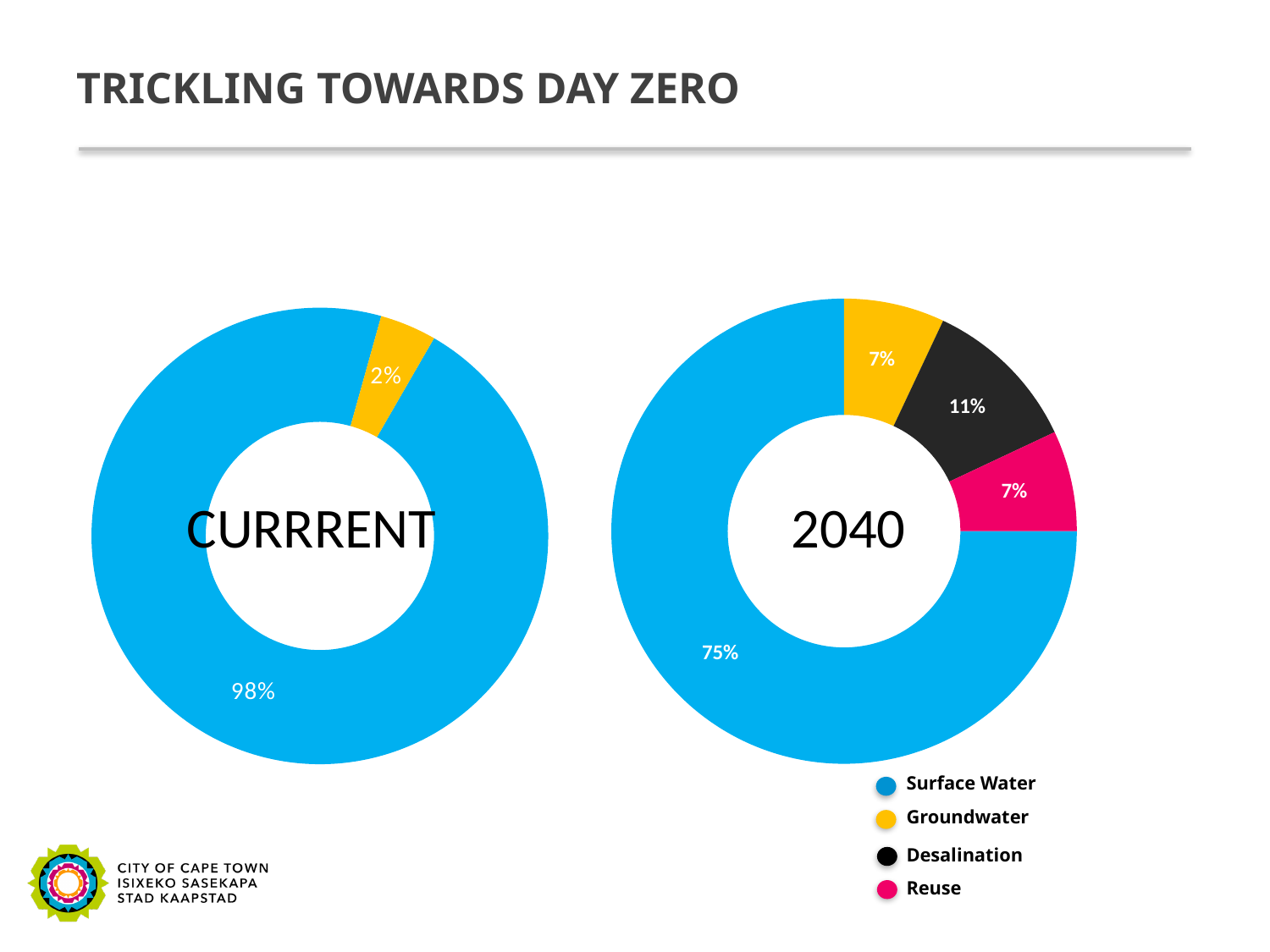
How many segments does the CURRRENT donut chart on the left have? 2 In the CURRRENT donut chart on the left, what share is Surface Water? 98% In the 2040 donut chart on the right, what share is Desalination? 11% In the 2040 donut chart on the right, which of Desalination or Groundwater has the larger share? Desalination In the 2040 donut chart on the right, what share is Surface Water? 75% In the 2040 donut chart on the right, what share is Reuse? 7% What is the difference between the Surface Water share in the CURRRENT chart and in the 2040 chart? 23% In the CURRRENT donut chart on the left, what share is Groundwater? 2% How many entries does the legend list? 4 What type of chart is used on this slide? Donut (pie) chart In the 2040 donut chart on the right, which source has the largest share? Surface Water How many segments does the 2040 donut chart on the right have? 4